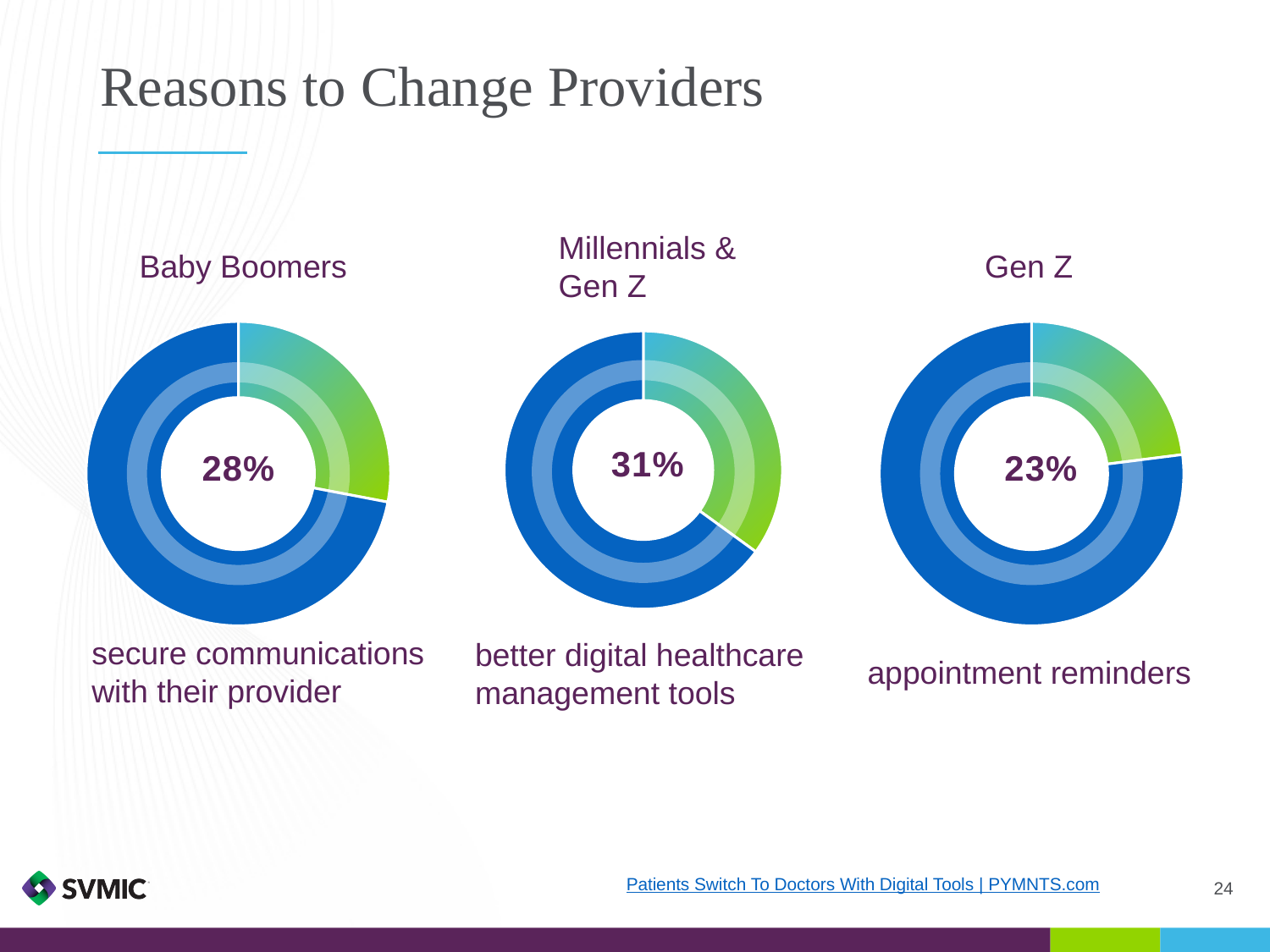
What is the title of the slide containing the three donut charts? Reasons to Change Providers How many donut charts are shown on the slide? 3 What is the difference between the percentage in the Millennials & Gen Z chart and the percentage in the Gen Z chart? 8% What reason is listed beneath the Gen Z donut chart? appointment reminders In the Millennials & Gen Z donut chart, what percentage is shown in the centre? 31% What is the difference between the percentage in the Baby Boomers chart and the percentage in the Gen Z chart? 5% Across the three donut charts, which group has the lowest percentage? Gen Z In the Gen Z donut chart, what percentage is shown in the centre? 23% In the Baby Boomers donut chart, what percentage is shown in the centre? 28% What kind of chart is used for each group on the slide? Donut chart Which is larger: the percentage in the Baby Boomers chart or the percentage in the Millennials & Gen Z chart? Millennials & Gen Z Across the three donut charts, which group has the highest percentage? Millennials & Gen Z